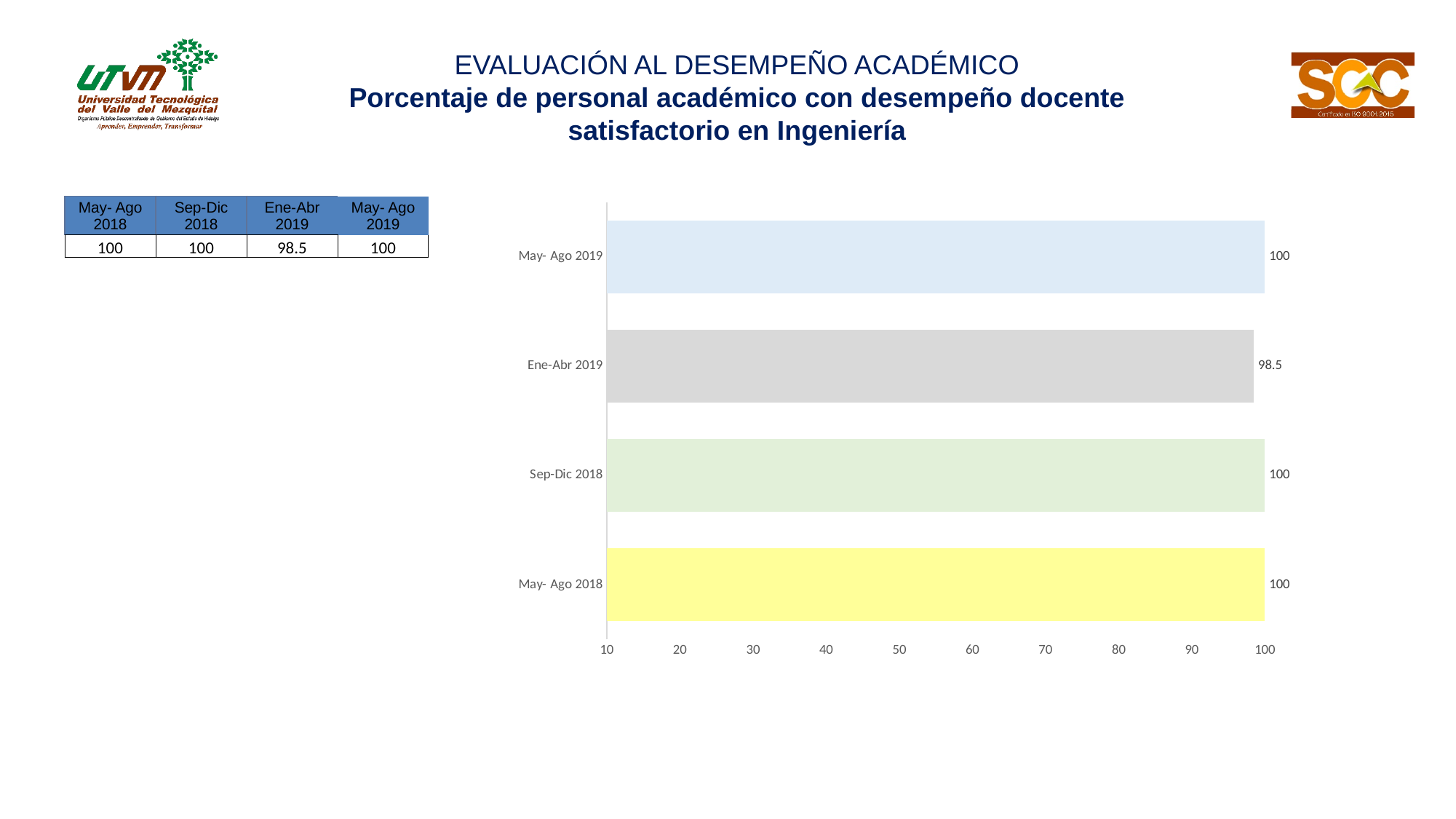
Which period has the lowest value? Ene-Abr 2019 What is the value for Ene-Abr 2019? 98.5 Which is larger, the value for Sep-Dic 2018 or the value for Ene-Abr 2019? Sep-Dic 2018 What is the value for Sep-Dic 2018? 100 What is the difference between the values for May- Ago 2018 and Ene-Abr 2019? 1.5 What is the value for May- Ago 2019? 100 How many periods have a value of 100? 3 How many periods are shown in the chart? 4 What kind of chart is shown on the slide? bar chart What colour is the bar for May- Ago 2018? yellow What is the highest value shown on the horizontal axis? 100 Is the value for Ene-Abr 2019 greater or less than 90? greater